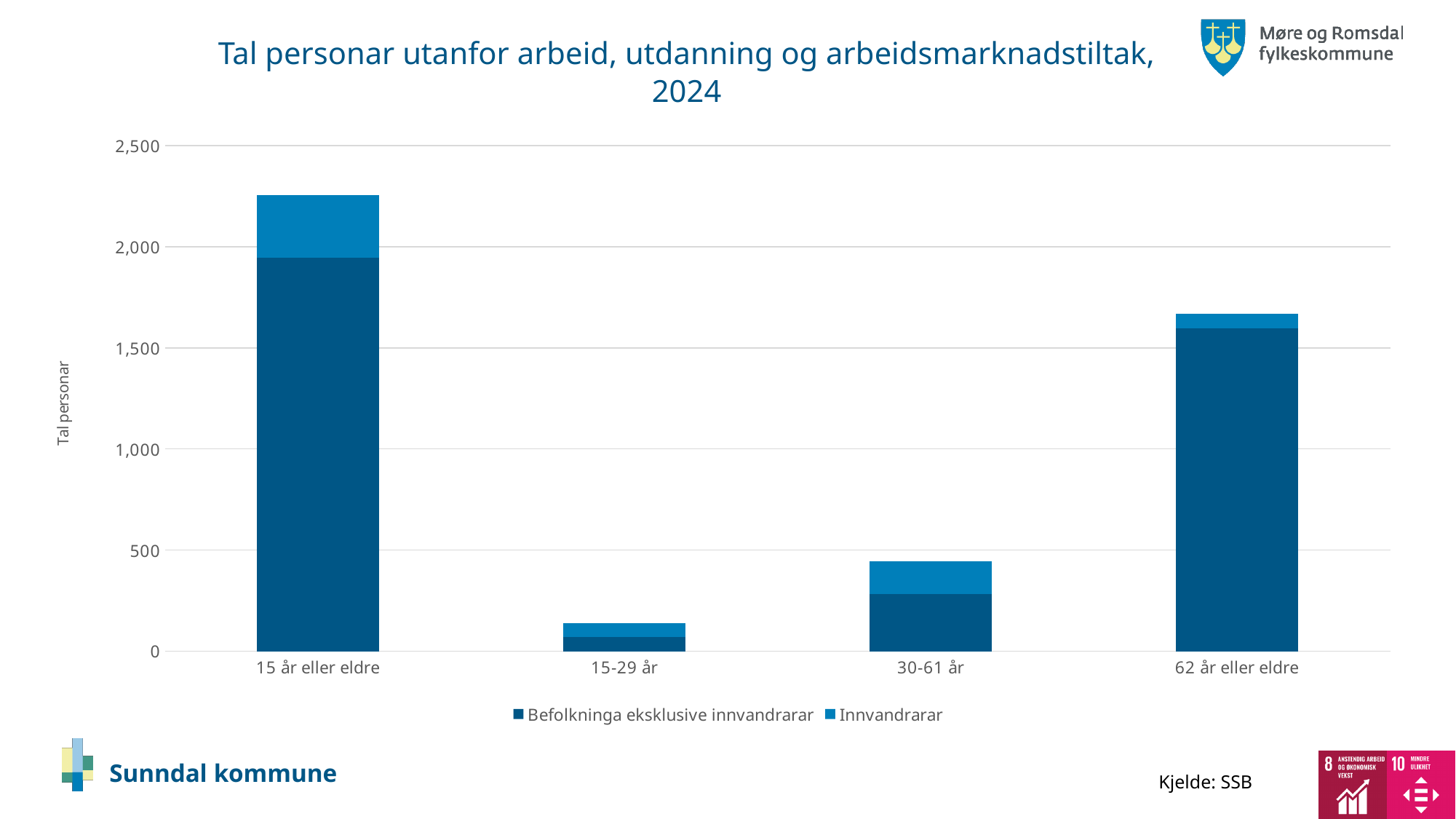
Which age category has the lowest total bar? 15-29 år What kind of chart is shown on the slide? Stacked bar chart What are the two series named in the legend? Befolkninga eksklusive innvandrarar and Innvandrarar What is the label on the y axis? Tal personar Which has the larger total bar, 30-61 år or 15-29 år? 30-61 år Is the total bar for 15 år eller eldre greater or less than 2,000? greater Is the total bar for 62 år eller eldre greater or less than 1,500? greater How many series does the legend list? 2 Is the total bar for 30-61 år greater or less than 500? less Which age category has the highest total bar? 15 år eller eldre How many age categories are shown on the x axis? 4